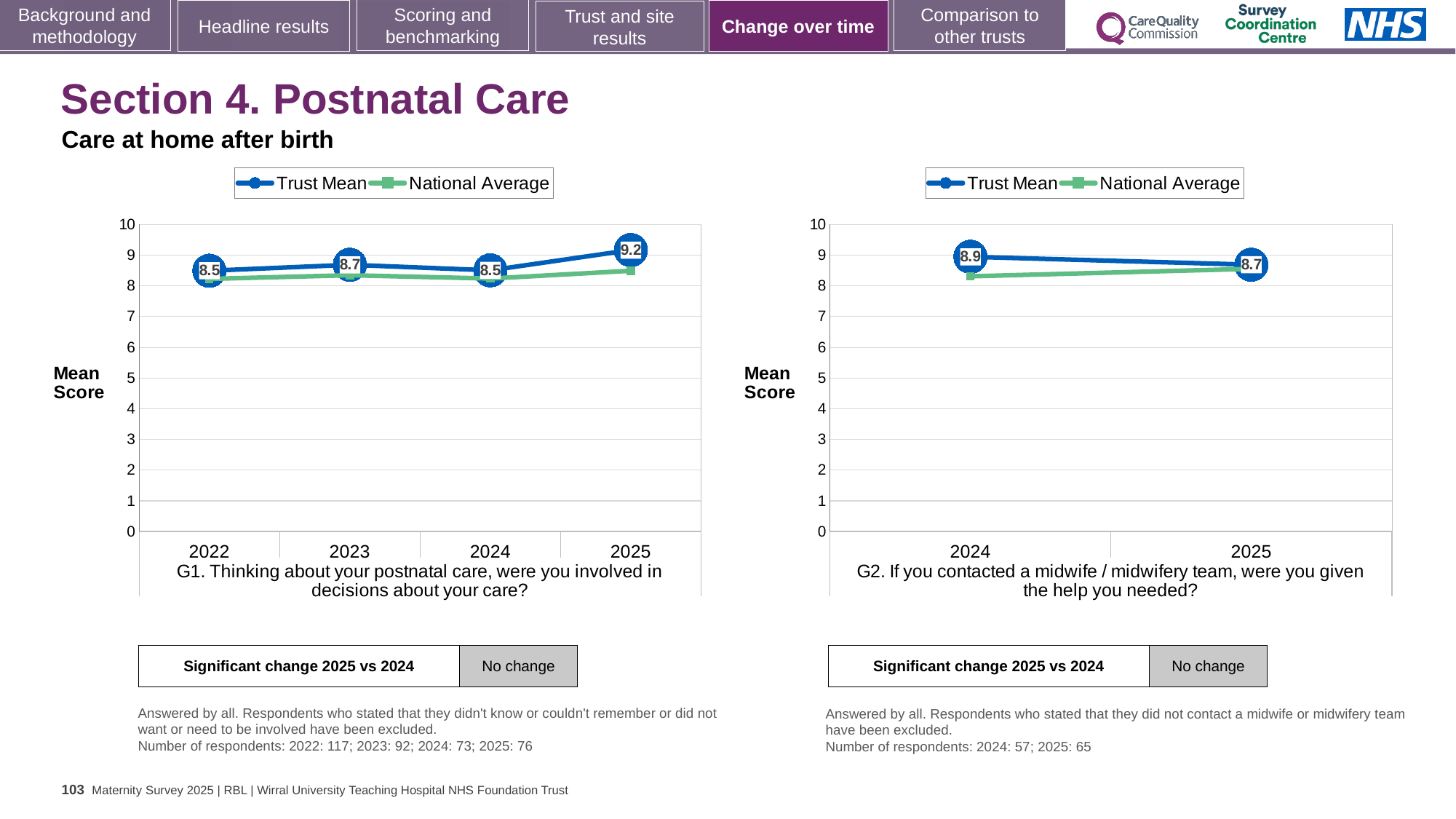
How many series does the legend of the G2 chart (right) list? 2 In the G1 chart (left), is the Trust Mean higher in 2023 or in 2025? 2025 In the G2 chart (right), what is the difference between the Trust Mean for 2024 and 2025? 0.2 In the G1 chart (left), is the National Average for 2025 greater or less than 8? greater In the G2 chart (right), which year has the lower Trust Mean? 2025 In the G1 chart (left), what is the difference between the Trust Mean for 2025 and the Trust Mean for 2024? 0.7 In the G1 chart (left), what is the Trust Mean for 2023? 8.7 How many years are shown on the x axis of the G1 chart (left)? 4 In the G2 chart (right), what is the Trust Mean for 2024? 8.9 In the G1 chart (left), which year has the highest Trust Mean? 2025 In the G1 chart (left), what is the Trust Mean for 2025? 9.2 What type of chart is the G2 chart (right)? Line chart